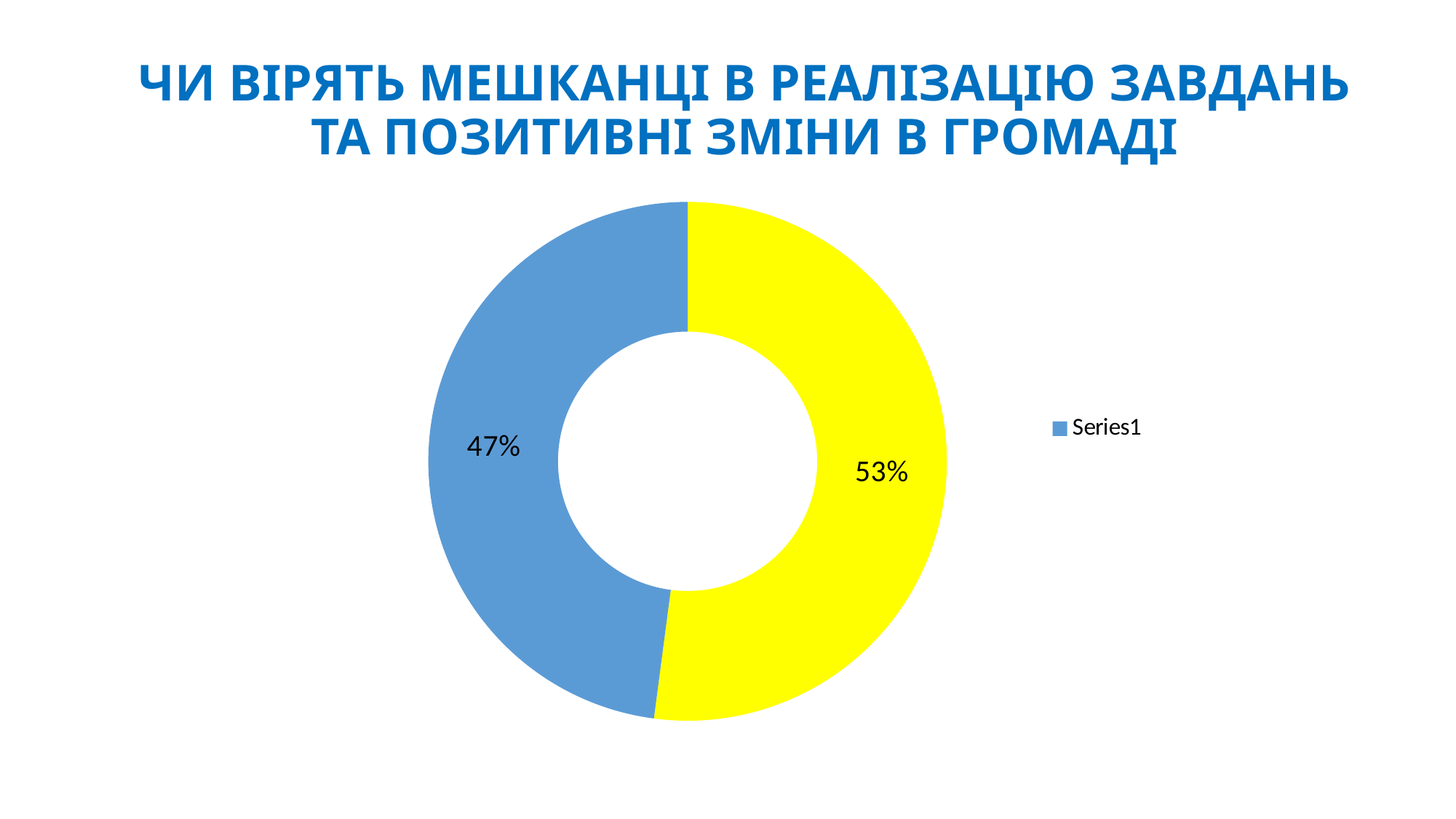
Is the blue slice's value larger or smaller than the yellow slice's value? Smaller What do the two slice values add up to? 100% Which slice has the smallest share, the blue or the yellow one? Blue What series name is listed in the chart legend? Series1 Which slice has the largest share, the blue or the yellow one? Yellow Is the value of the yellow slice greater or less than 50%? greater What is the difference between the yellow slice's value and the blue slice's value? 6% What kind of chart is shown on the slide? Doughnut (pie) chart How many slices does the doughnut chart have? 2 What value is shown on the yellow slice of the chart? 53% What value is shown on the blue slice of the chart? 47% What is the title of the slide? ЧИ ВІРЯТЬ МЕШКАНЦІ В РЕАЛІЗАЦІЮ ЗАВДАНЬ ТА ПОЗИТИВНІ ЗМІНИ В ГРОМАДІ